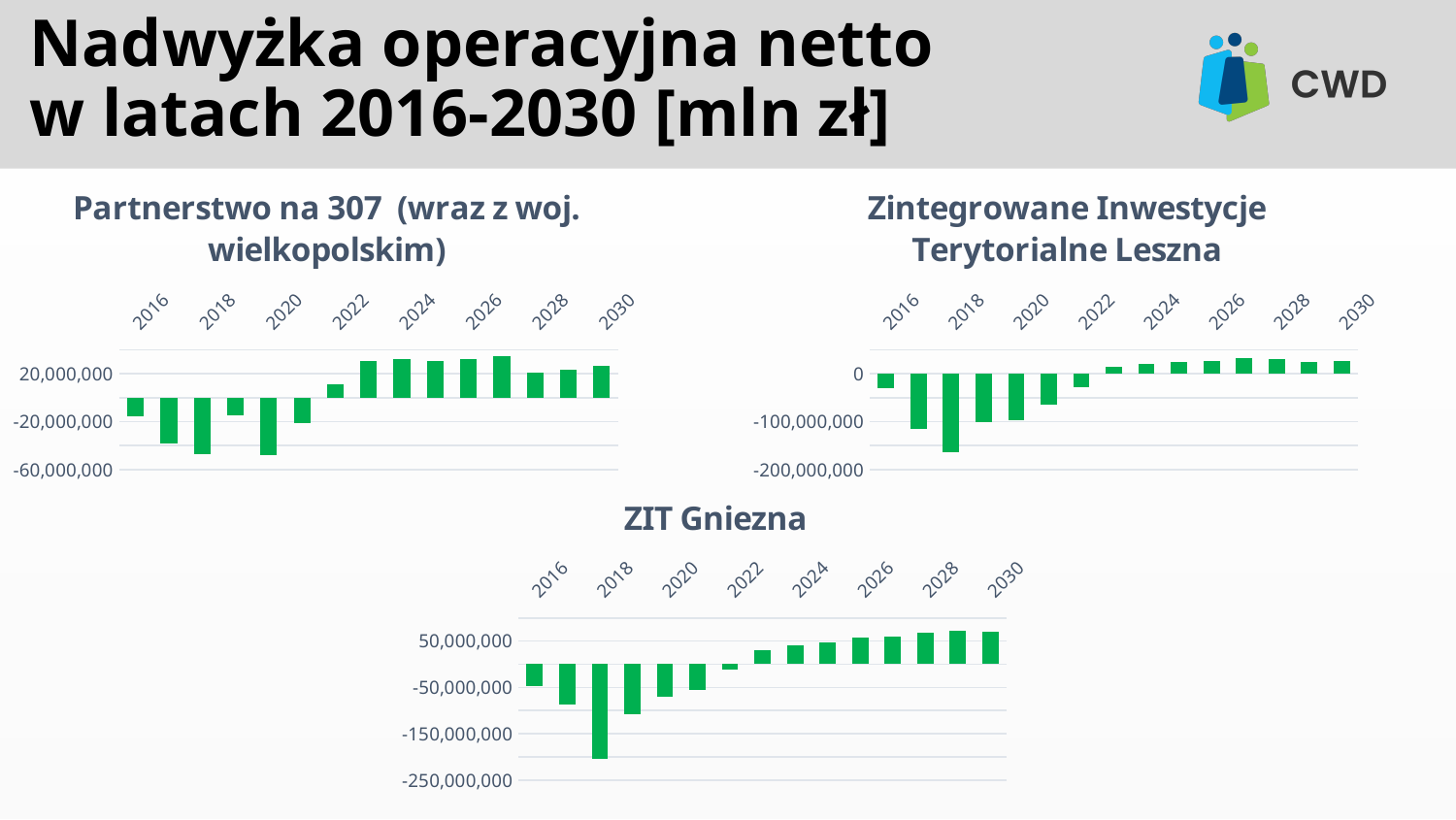
What kind of chart is the 'ZIT Gniezna' chart? bar chart In the 'Partnerstwo na 307 (wraz z woj. wielkopolskim)' chart, is the value for 2019 greater or less than -20,000,000? greater How many years are plotted on the 'ZIT Gniezna' chart? 15 In the 'ZIT Gniezna' chart, which year has the lowest value? 2018 How many charts are shown on the slide? 3 In the 'ZIT Gniezna' chart, is the value for 2017 greater or less than -50,000,000? less In the 'Zintegrowane Inwestycje Terytorialne Leszna' chart, do the values generally rise or fall from 2018 to 2030? rise In the 'Partnerstwo na 307 (wraz z woj. wielkopolskim)' chart, is the value for 2027 greater or less than 20,000,000? greater In the 'Zintegrowane Inwestycje Terytorialne Leszna' chart, which year has the lowest value? 2018